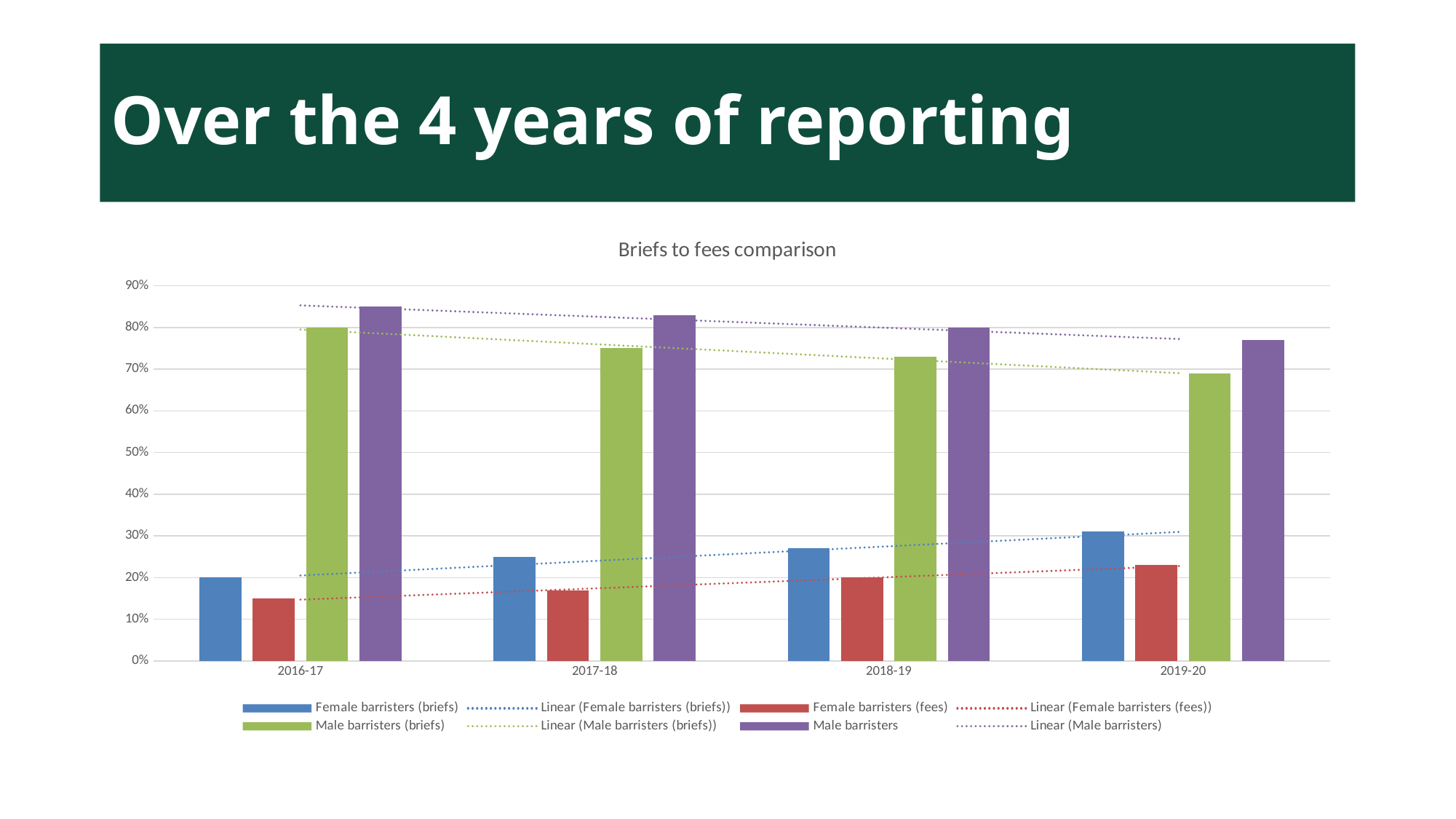
What type of chart is shown on the slide? Bar chart Do the values for Female barristers (briefs) rise or fall from 2016-17 to 2019-20? rise What is the title of the chart? Briefs to fees comparison Is the value for Female barristers (fees) in 2016-17 greater or less than 20%? less How many reporting years are shown on the x axis? 4 In 2017-18, which is larger: Male barristers (briefs) or Female barristers (briefs)? Male barristers (briefs) Do the values for Male barristers (briefs) rise or fall from 2016-17 to 2019-20? fall What is the value for Female barristers (briefs) in 2016-17? 20% How many entries does the chart legend list? 8 What is the value for Male barristers (briefs) in 2016-17? 80%